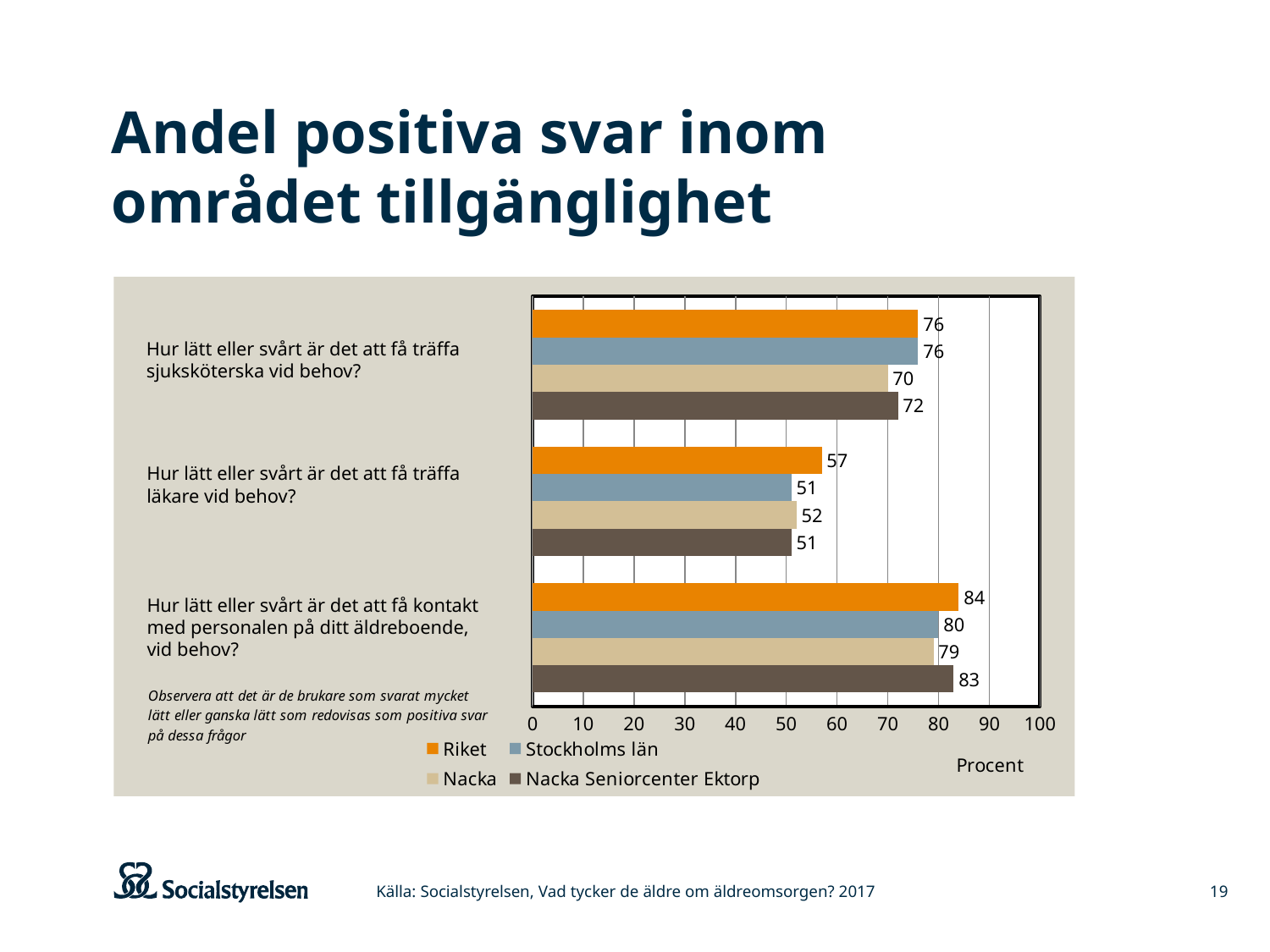
Which is larger on the question "Hur lätt eller svårt är det att få kontakt med personalen på ditt äldreboende, vid behov?": Stockholms län or Nacka Seniorcenter Ektorp? Nacka Seniorcenter Ektorp What kind of chart is shown on the slide? Bar chart What is the label of the horizontal axis? Procent Which series has the highest value on the question "Hur lätt eller svårt är det att få kontakt med personalen på ditt äldreboende, vid behov?"? Riket Is the value for Nacka on the question "Hur lätt eller svårt är det att få träffa läkare vid behov?" greater or less than 60? less Which series has the lowest value on the question "Hur lätt eller svårt är det att få träffa sjuksköterska vid behov?"? Nacka What is the difference between Riket and Nacka Seniorcenter Ektorp on the question "Hur lätt eller svårt är det att få träffa läkare vid behov?"? 6 How many questions (categories) are shown in the chart? 3 What is the value for Riket on the question "Hur lätt eller svårt är det att få träffa läkare vid behov?"? 57 What is the value for Nacka on the question "Hur lätt eller svårt är det att få träffa sjuksköterska vid behov?"? 70 How many series does the legend list? 4 What is the value for Nacka Seniorcenter Ektorp on the question "Hur lätt eller svårt är det att få kontakt med personalen på ditt äldreboende, vid behov?"? 83